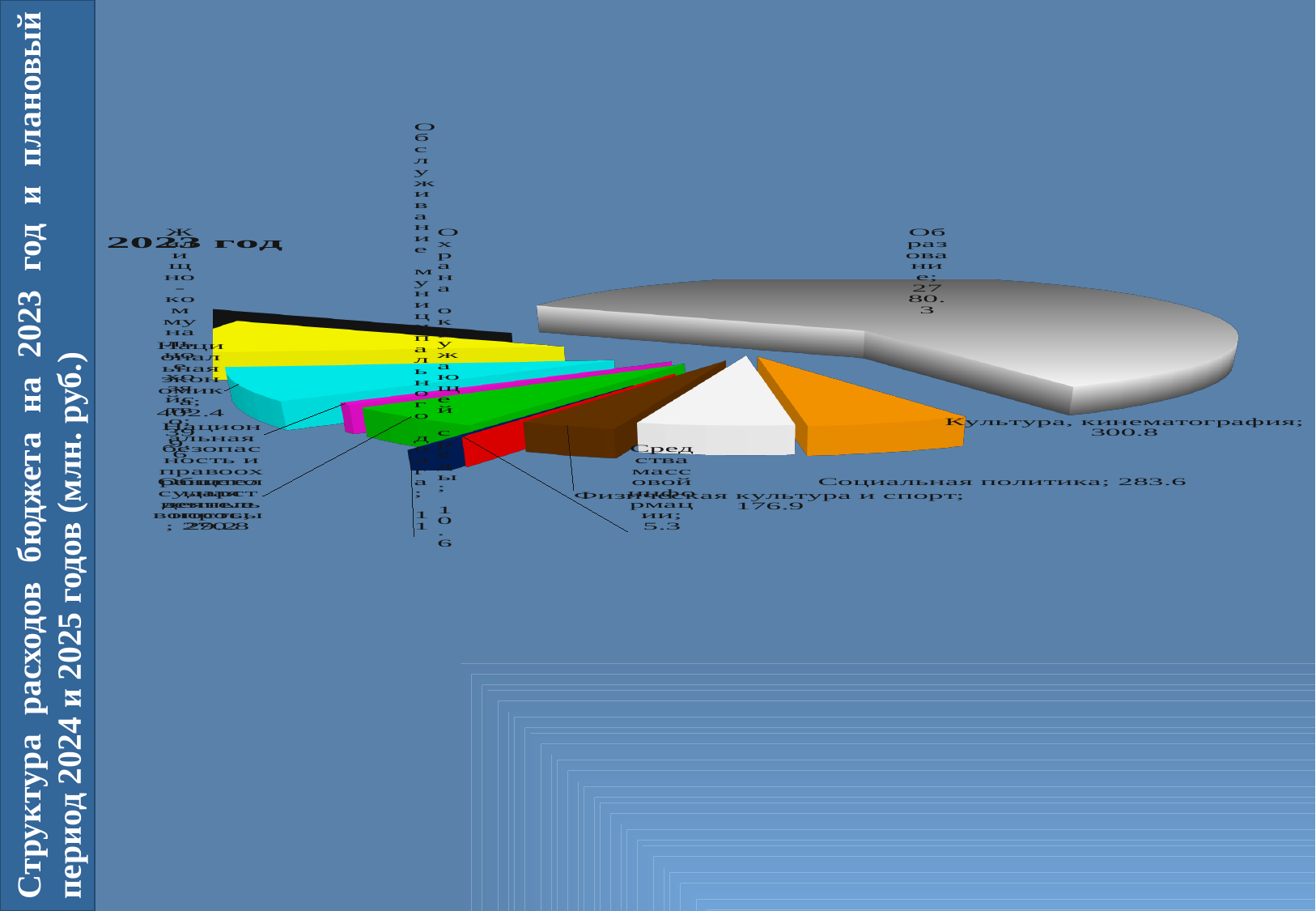
What is the value for Культура, кинематография? 300.8 What kind of chart is shown on the slide? pie chart What is the difference between Культура, кинематография and Социальная политика? 17.2 Which is larger: Культура, кинематография or Социальная политика? Культура, кинематография Which category has the largest slice of the pie? Образование What is the value for Образование in the pie chart? 2780.3 What is the difference between Социальная политика and Физическая культура и спорт? 106.7 What is the value for Социальная политика? 283.6 Which is larger: Физическая культура и спорт or Средства массовой информации? Физическая культура и спорт What is the title of the pie chart? 2023 год What is the value for Средства массовой информации? 5.3 What is the value for Физическая культура и спорт? 176.9